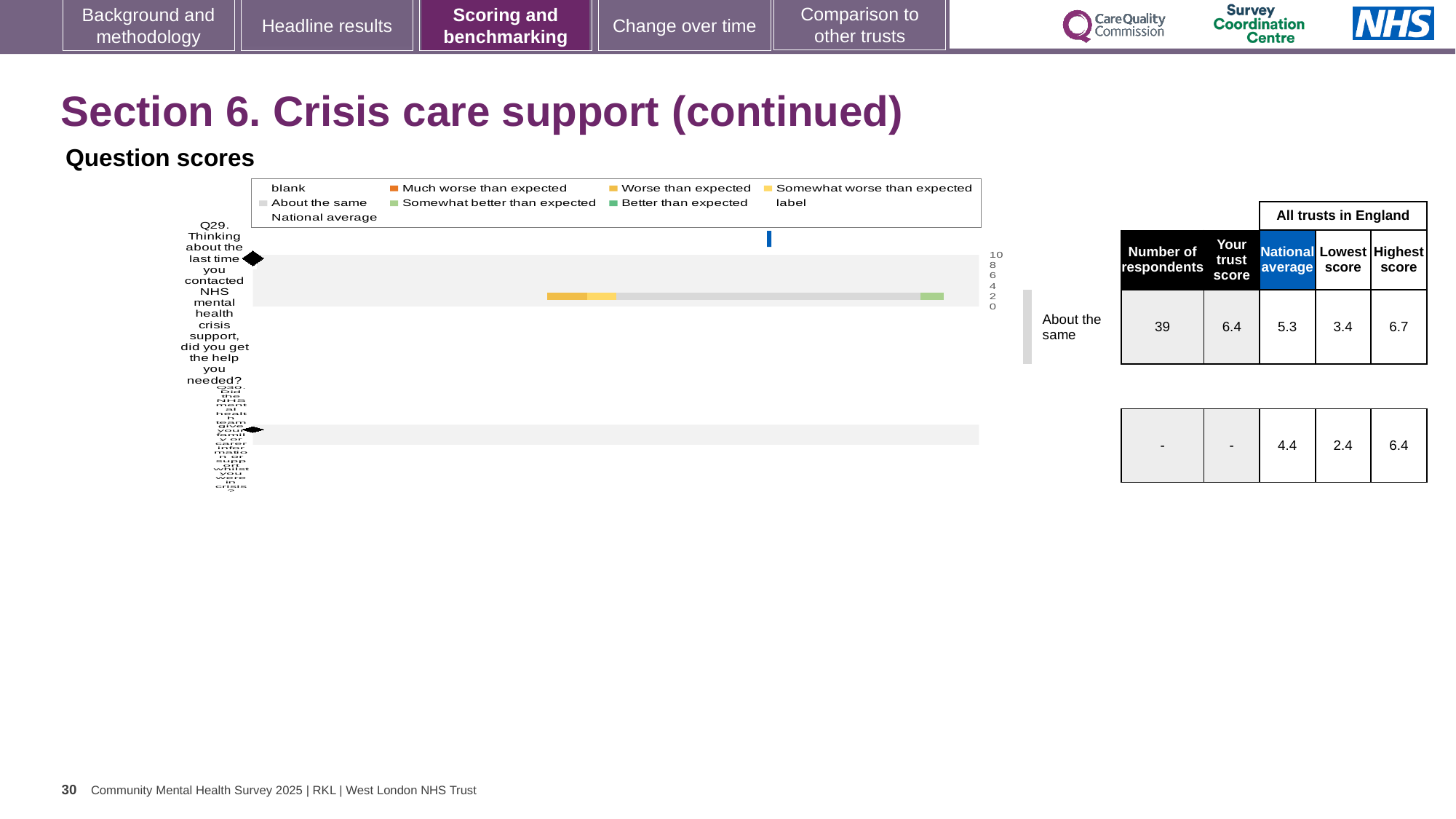
What kind of chart is used to show the question scores on this slide? bar chart What is the trust score for Q29 (Thinking about the last time you contacted NHS mental health crisis support, did you get the help you needed?)? 6.4 How many respondents answered Q29? 39 What is the highest score among all trusts in England for Q29? 6.7 For Q29, what is the difference between the highest score and the lowest score among all trusts in England? 3.3 What benchmark category label is shown next to the Q29 bar? About the same What is the highest score among all trusts in England for Q30? 6.4 How many questions are plotted in the question scores chart? 2 For Q29, which is larger: the trust score or the national average? the trust score What is the national average score for Q29? 5.3 What is the lowest score among all trusts in England for Q29? 3.4 What is the national average score for Q30? 4.4